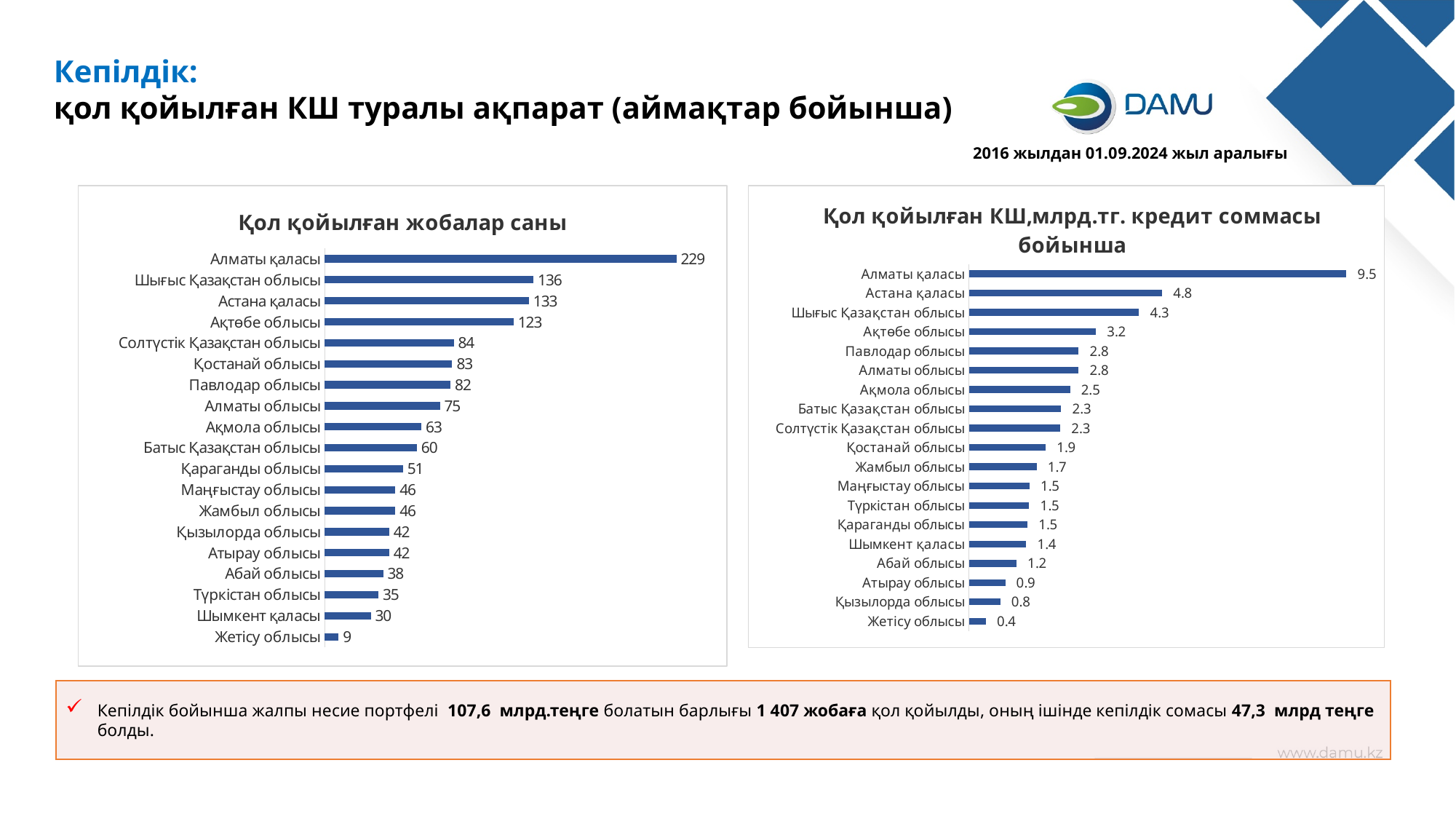
In the chart 'Қол қойылған жобалар саны', what is the value for Ақтөбе облысы? 123 In the chart 'Қол қойылған КШ,млрд.тг. кредит соммасы бойынша', which category has the highest value? Алматы қаласы In the chart 'Қол қойылған жобалар саны', which category has the highest value? Алматы қаласы What type of chart is the chart on the right of the slide? Bar chart In the chart 'Қол қойылған жобалар саны', how many categories are shown? 19 In the chart 'Қол қойылған КШ,млрд.тг. кредит соммасы бойынша', which is larger: the value for Ақтөбе облысы or Павлодар облысы? Ақтөбе облысы In the chart 'Қол қойылған жобалар саны', what is the value for Шымкент қаласы? 30 In the chart 'Қол қойылған жобалар саны', which category has the lowest value? Жетісу облысы In the chart 'Қол қойылған КШ,млрд.тг. кредит соммасы бойынша', what is the value for Қызылорда облысы? 0.8 In the chart 'Қол қойылған жобалар саны', what is the difference between the values for Алматы қаласы and Шығыс Қазақстан облысы? 93 In the chart 'Қол қойылған КШ,млрд.тг. кредит соммасы бойынша', what is the value for Астана қаласы? 4.8 In the chart 'Қол қойылған КШ,млрд.тг. кредит соммасы бойынша', what is the difference between the values for Алматы қаласы and Жетісу облысы? 9.1